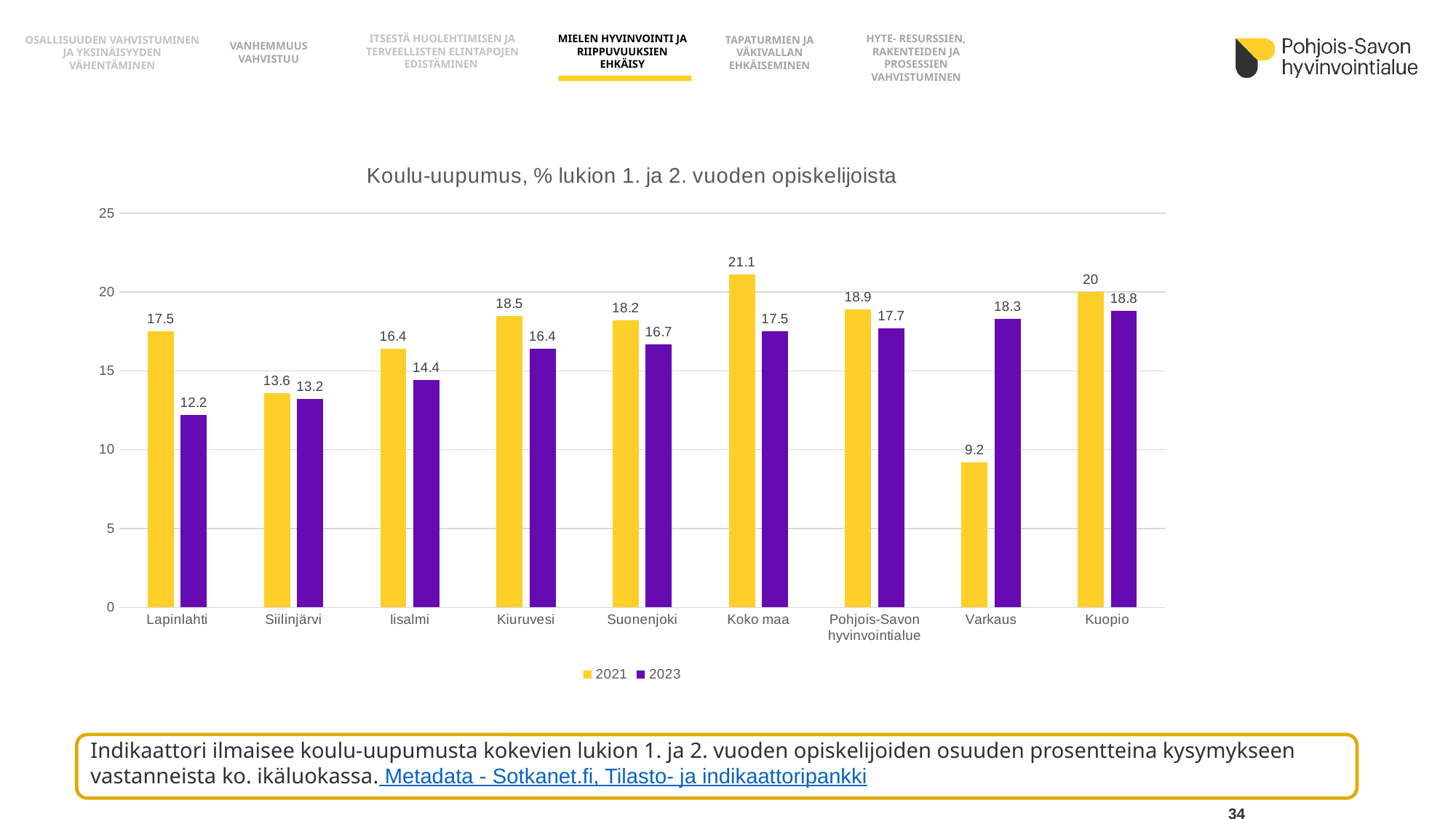
What is the title of the chart? Koulu-uupumus, % lukion 1. ja 2. vuoden opiskelijoista Which category has the highest 2021 value? Koko maa What is the 2021 value for Lapinlahti? 17.5 Which is larger for Varkaus, the 2021 value or the 2023 value? 2023 How many categories are shown on the x axis? 9 What is the 2023 value for Varkaus? 18.3 What is the 2023 value for Pohjois-Savon hyvinvointialue? 17.7 How many series does the legend list? 2 What kind of chart is shown on the slide? bar chart Is the 2021 value for Varkaus greater or less than 10? less What is the difference between the 2021 and 2023 values for Lapinlahti? 5.3 Which category has the lowest 2023 value? Lapinlahti